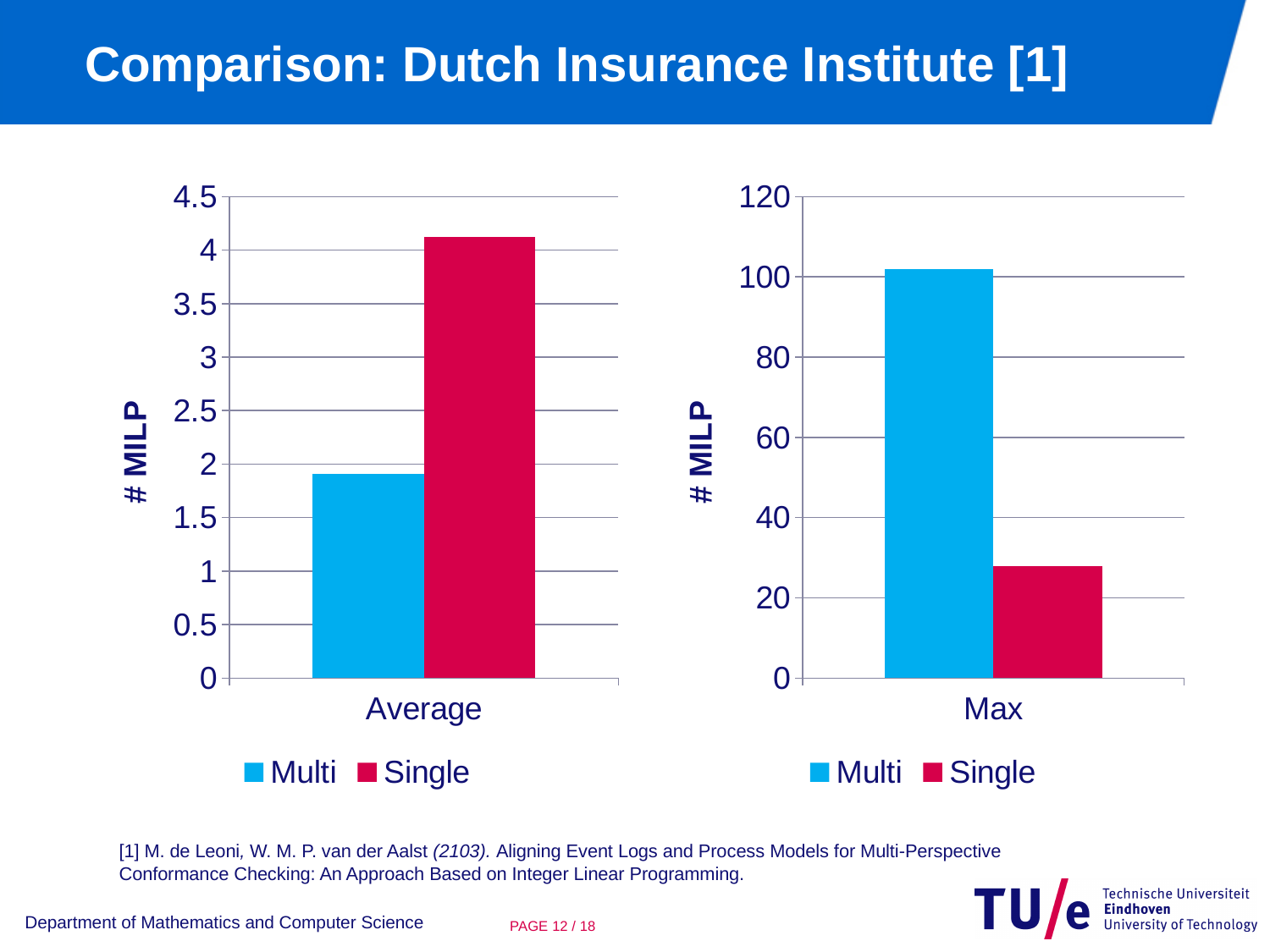
In the left chart (Average), how many series does the legend list? 2 In the right chart (Max), is the value for Single greater or less than 40? less How many categories are shown on the x axis of the left chart (Average)? 1 In the left chart (Average), which series has the larger value, Multi or Single? Single In the left chart (Average), is the value for Multi greater or less than 2? less What kind of chart is the left chart (Average)? bar chart In the right chart (Max), how many series does the legend list? 2 In the right chart (Max), is the value for Multi greater or less than 100? greater In the right chart (Max), which series has the larger value, Multi or Single? Multi What is the y-axis label of the right chart (Max)? # MILP What kind of chart is the right chart (Max)? bar chart